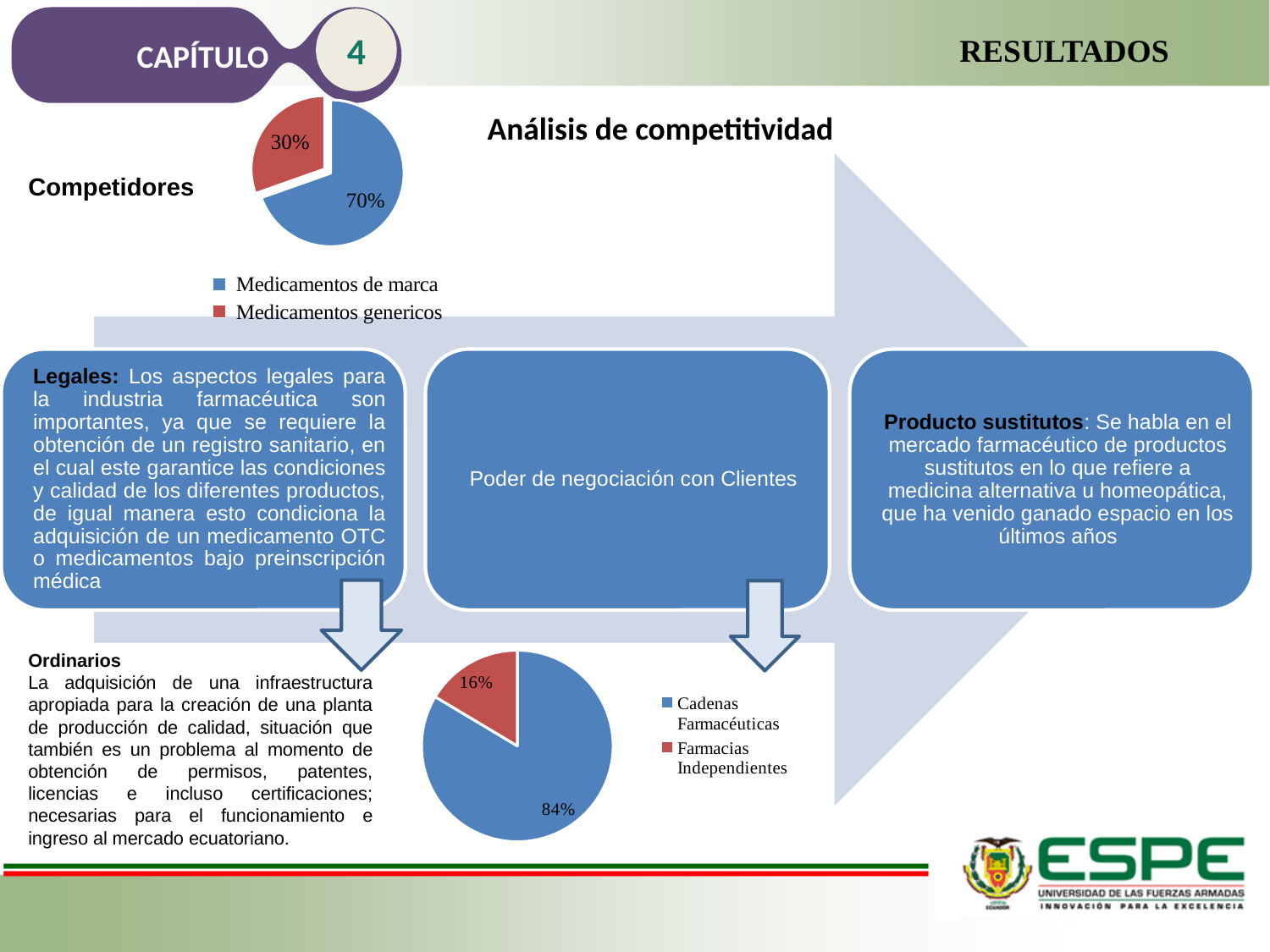
In the pie chart at the top left of the slide, what is the difference in percentage points between Medicamentos de marca and Medicamentos genericos? 40 How many entries does the legend of the pie chart at the bottom centre of the slide list? 2 How many slices does the pie chart at the top left of the slide have? 2 In the pie chart at the top left of the slide, what share is shown for Medicamentos de marca? 70% In the pie chart at the bottom centre of the slide, which is larger: Cadenas Farmacéuticas or Farmacias Independientes? Cadenas Farmacéuticas In the pie chart at the bottom centre of the slide, what share is shown for Farmacias Independientes? 16% In the pie chart at the bottom centre of the slide, what colour is the slice for Farmacias Independientes? Red In the pie chart at the top left of the slide, what share is shown for Medicamentos genericos? 30% What type of chart is the chart at the top left of the slide? Pie chart In the pie chart at the top left of the slide, which category has the largest slice? Medicamentos de marca In the pie chart at the bottom centre of the slide, which category has the smallest slice? Farmacias Independientes In the pie chart at the bottom centre of the slide, what share is shown for Cadenas Farmacéuticas? 84%